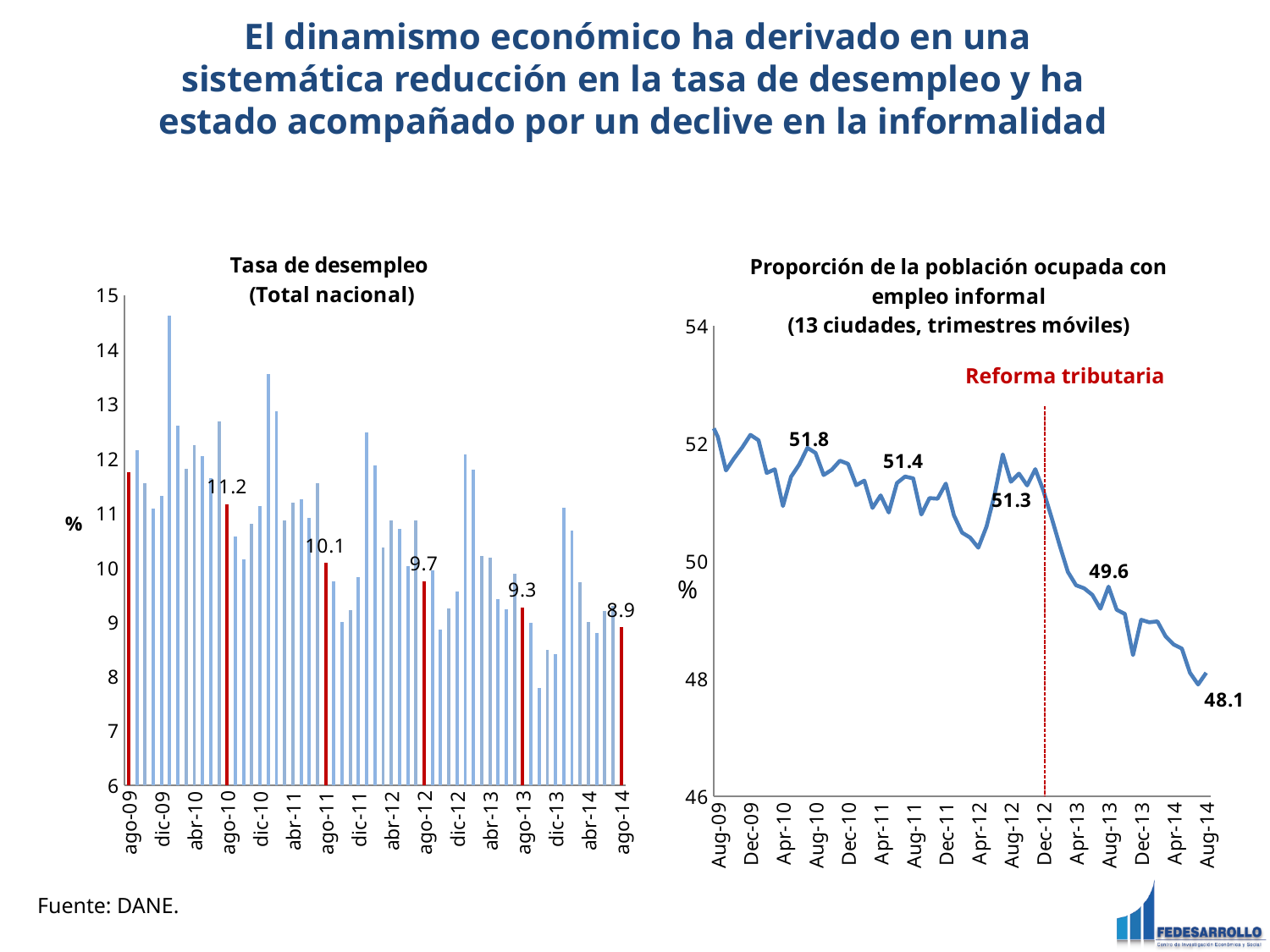
What kind of chart is the 'Proporción de la población ocupada con empleo informal' chart? Line chart In the 'Proporción de la población ocupada con empleo informal' chart, is the value at Dec-13 greater or less than 50? less In the 'Proporción de la población ocupada con empleo informal' chart, what is the difference between the labelled values 51.8 and 48.1? 3.7 In the 'Tasa de desempleo (Total nacional)' chart, what is the difference between the ago-13 and ago-14 values? 0.4 In the 'Proporción de la población ocupada con empleo informal' chart, what event does the red dashed vertical line mark? Reforma tributaria What kind of chart is the 'Tasa de desempleo (Total nacional)' chart? Bar chart In the 'Tasa de desempleo (Total nacional)' chart, what is the unemployment rate for ago-10? 11.2 In the 'Tasa de desempleo (Total nacional)' chart, what is the unemployment rate for ago-14? 8.9 In the 'Proporción de la población ocupada con empleo informal' chart, what is the value labelled at Aug-14? 48.1 In the 'Tasa de desempleo (Total nacional)' chart, by how much did the unemployment rate fall from ago-10 to ago-14? 2.3 In the 'Proporción de la población ocupada con empleo informal' chart, does the line generally rise or fall from Aug-09 to Aug-14? Fall In the 'Tasa de desempleo (Total nacional)' chart, which is higher, the value for ago-12 or for ago-13? ago-12